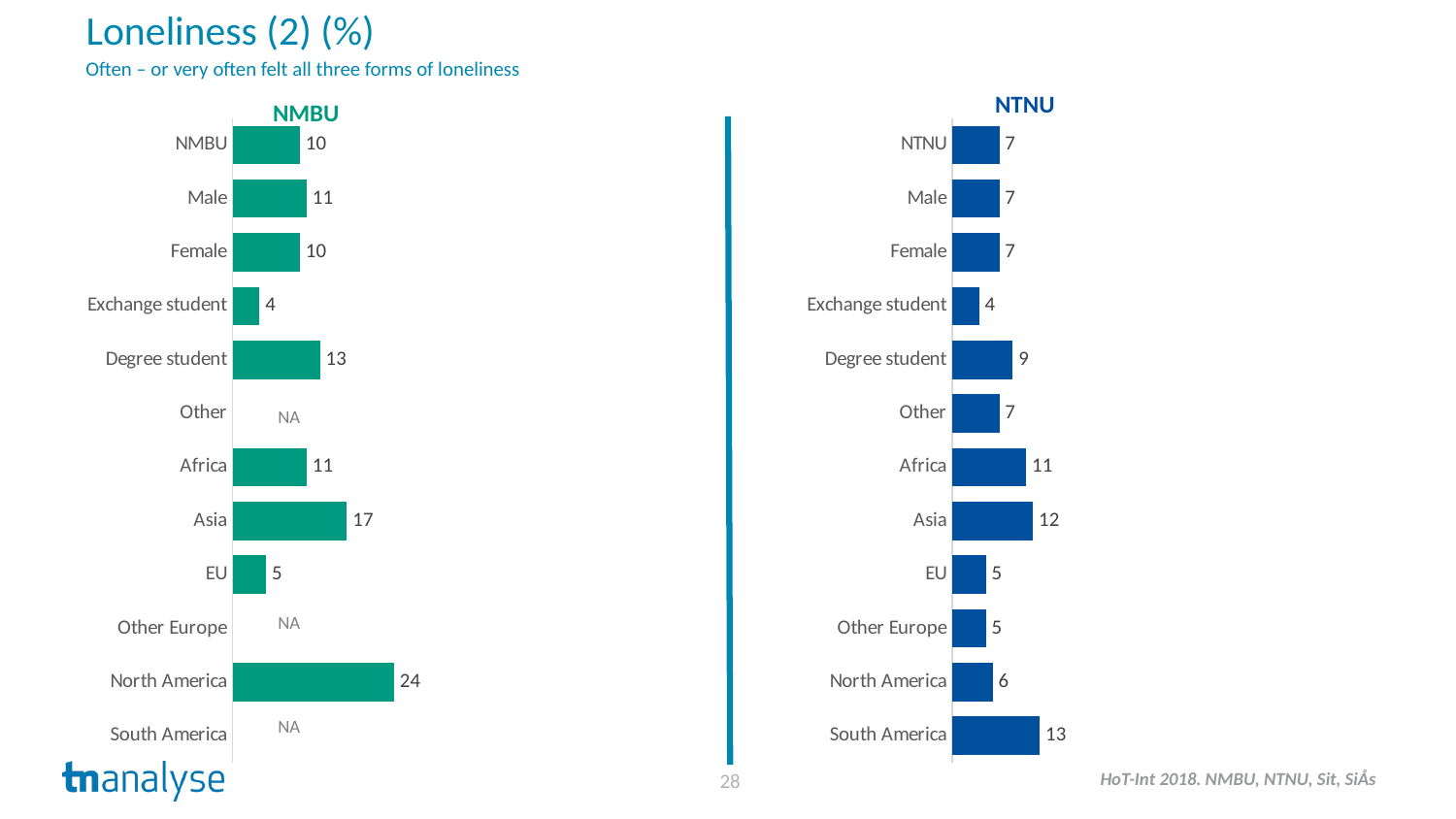
In the NTNU chart, what is the difference between the values for Asia and EU? 7 In the NMBU chart, how many categories are marked NA? 3 In the NMBU chart, what is the value for North America? 24 In the NMBU chart, what is the value for Asia? 17 In the NTNU chart, what is the value for South America? 13 In the NMBU chart, which category has the highest value? North America In the NTNU chart, what is the value for Degree student? 9 Which is larger: the value for North America in the NMBU chart or the value for North America in the NTNU chart? NMBU What is the subtitle of the slide? Often – or very often felt all three forms of loneliness In the NMBU chart, what is the difference between the values for Degree student and Exchange student? 9 What type of chart is the NTNU chart? Bar chart In the NTNU chart, which category has the lowest value? Exchange student